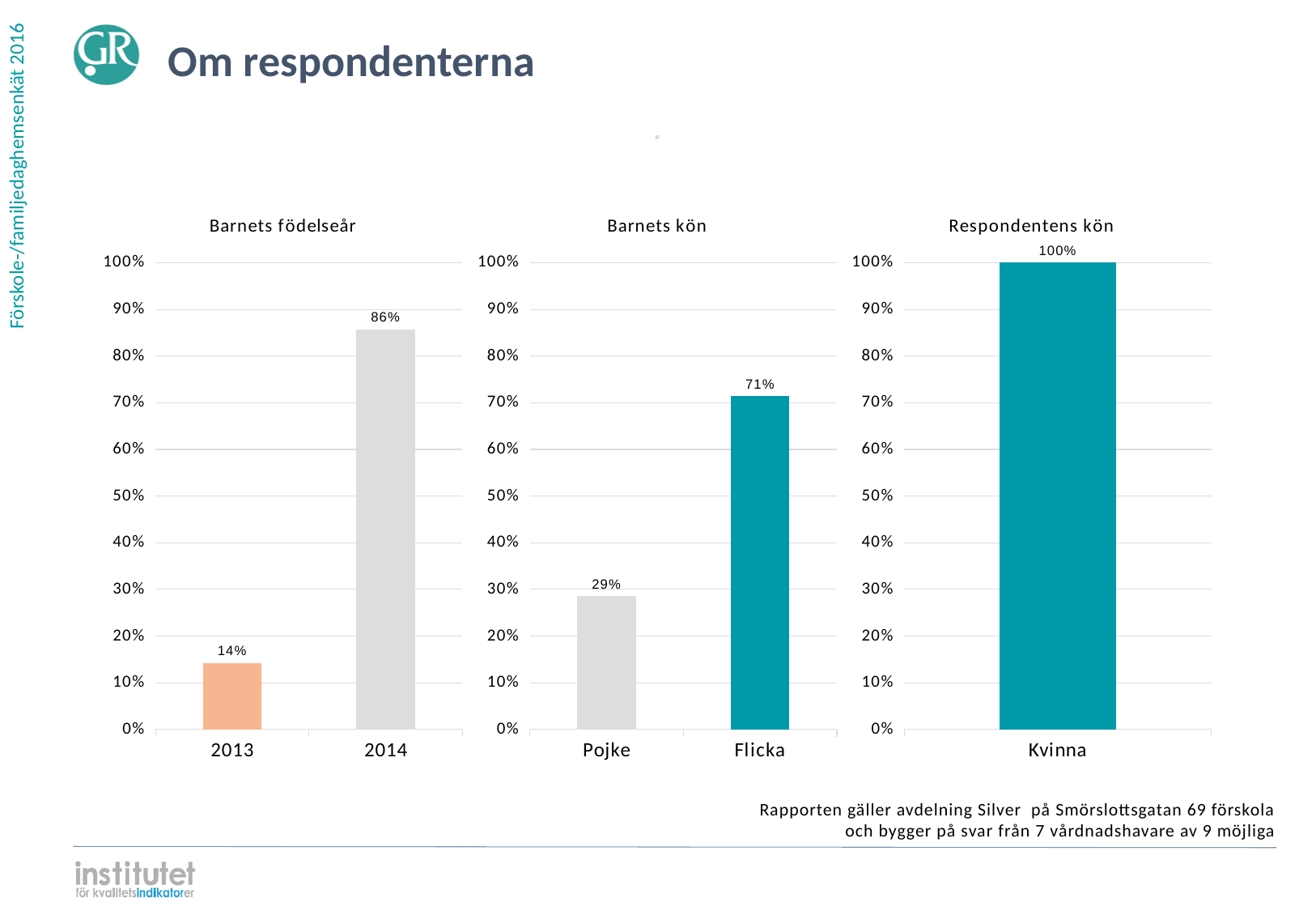
In the 'Respondentens kön' chart, what is the value for Kvinna? 100% In the 'Barnets födelseår' chart, what is the value for 2014? 86% In the 'Barnets kön' chart, what is the difference between the values for Flicka and Pojke? 42% In the 'Barnets kön' chart, what is the value for Pojke? 29% In the 'Barnets födelseår' chart, which category has the highest value? 2014 In the 'Barnets kön' chart, which category has the lowest value? Pojke What kind of chart is the 'Barnets kön' chart? Bar chart In the 'Barnets kön' chart, is the value for Pojke greater or less than 30%? less In the 'Barnets kön' chart, what is the value for Flicka? 71% In the 'Barnets födelseår' chart, what is the difference between the values for 2014 and 2013? 72% How many categories are shown in the 'Respondentens kön' chart? 1 In the 'Barnets födelseår' chart, what is the value for 2013? 14%